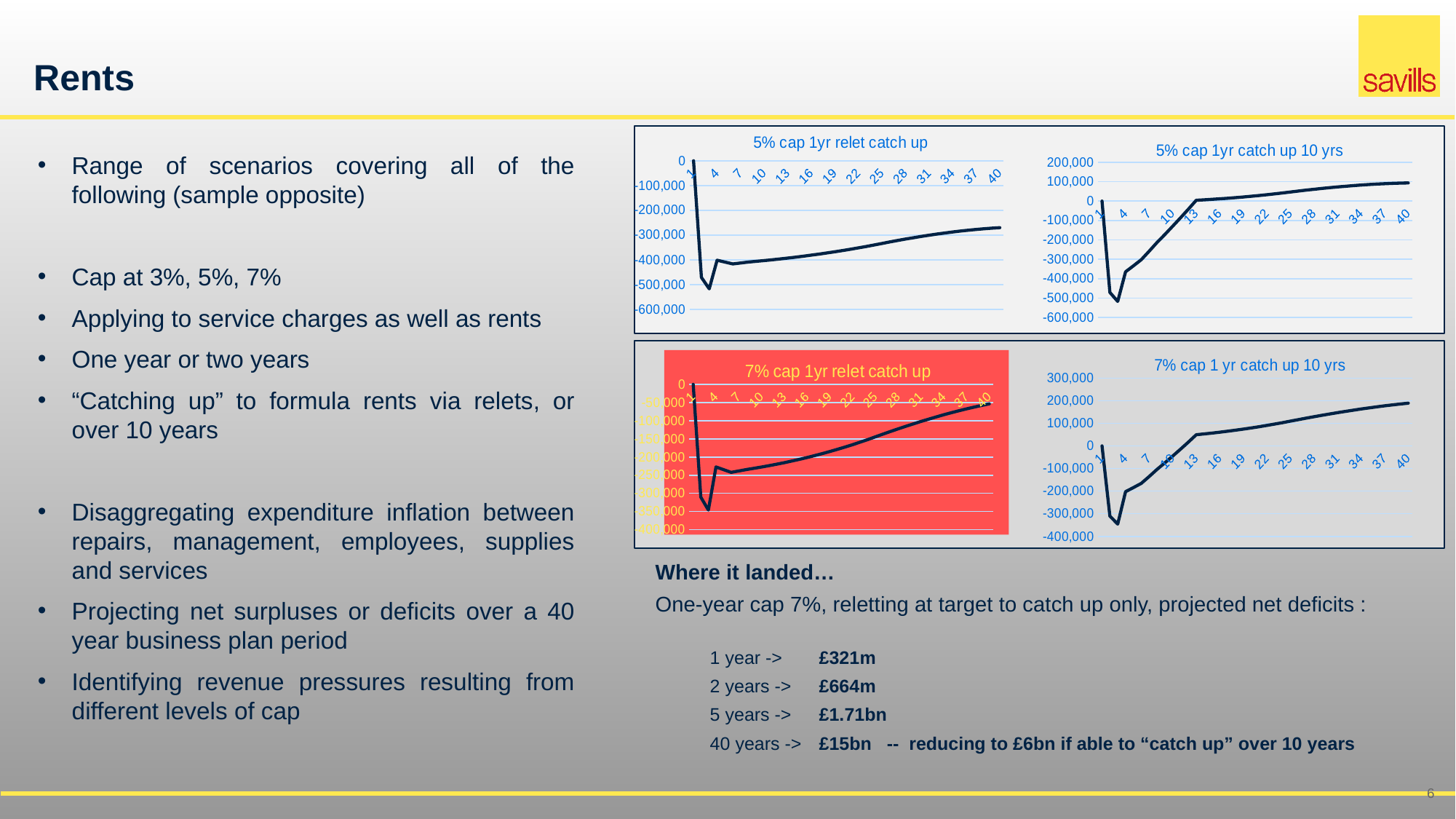
In the top-left chart '5% cap 1yr relet catch up', which is larger: the value at year 4 or the value at year 40? year 40 Which of the four charts has a red background? 7% cap 1yr relet catch up What kind of chart is the top-left chart titled '5% cap 1yr relet catch up'? line chart In the bottom-right chart '7% cap 1 yr catch up 10 yrs', does the line rise or fall between year 4 and year 40? rise How many charts are shown on the slide? 4 How many labelled tick marks are on the x axis of the top-right chart '5% cap 1yr catch up 10 yrs'? 14 In the top-right chart '5% cap 1yr catch up 10 yrs', is the lowest point of the line greater or less than -400,000? less In the bottom-left chart '7% cap 1yr relet catch up', is the value at year 40 greater or less than -100,000? greater In the bottom-right chart '7% cap 1 yr catch up 10 yrs', is the value at year 40 greater or less than 100,000? greater